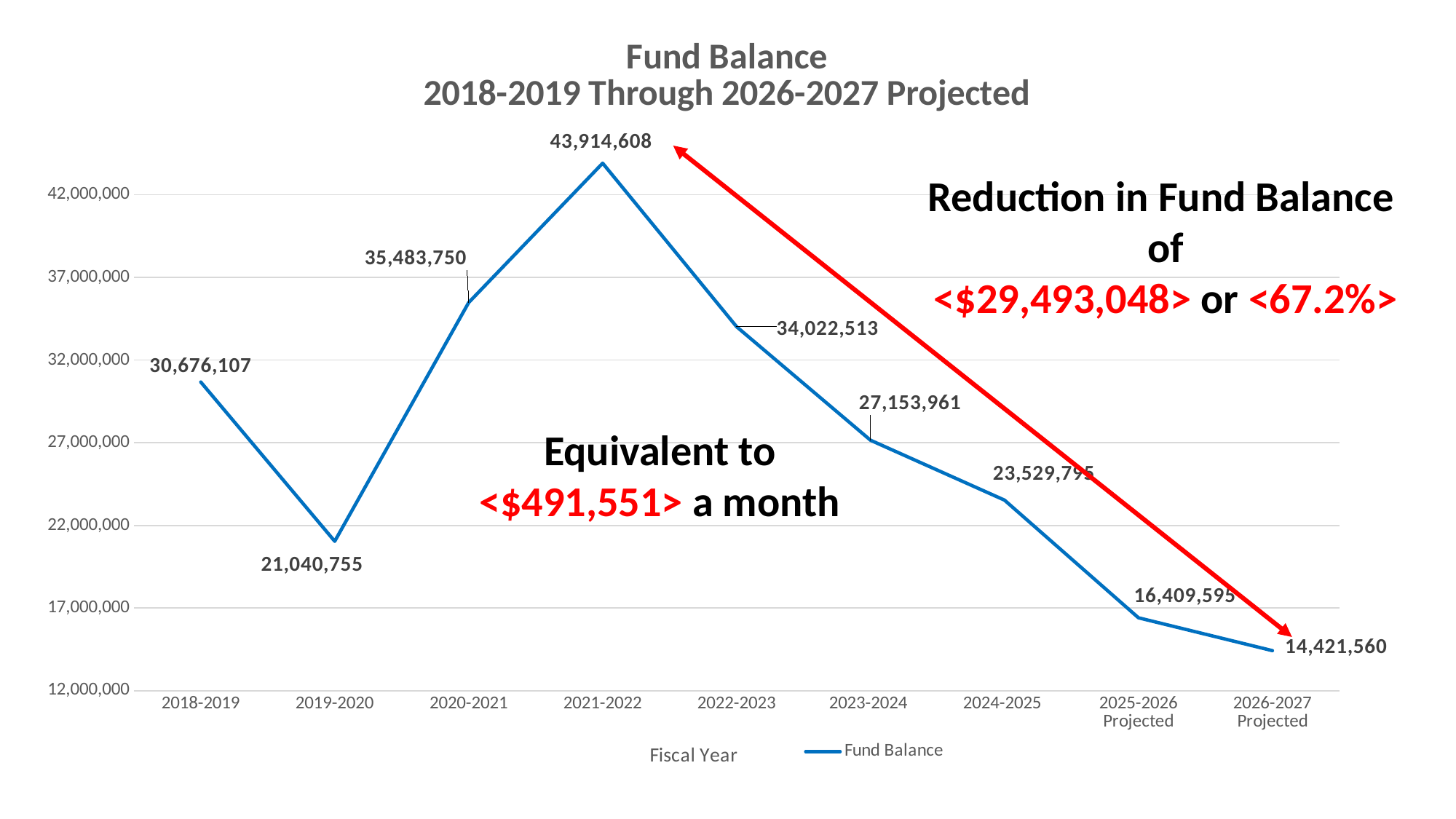
What is the fund balance for 2023-2024? 27,153,961 Which fiscal year has the highest fund balance? 2021-2022 What is the difference between the fund balance in 2021-2022 and the projected fund balance in 2026-2027? 29,493,048 Which fiscal year has the lowest fund balance? 2026-2027 Projected What is the projected fund balance for 2026-2027? 14,421,560 How many fiscal years are plotted on the chart? 9 Does the fund balance rise or fall from 2021-2022 through 2026-2027 Projected? Fall Which is larger, the fund balance in 2020-2021 or in 2022-2023? 2020-2021 What is the fund balance for 2019-2020? 21,040,755 What is the difference between the fund balance in 2018-2019 and 2019-2020? 9,635,352 What kind of chart is shown on the slide? Line chart What is the fund balance for 2021-2022? 43,914,608